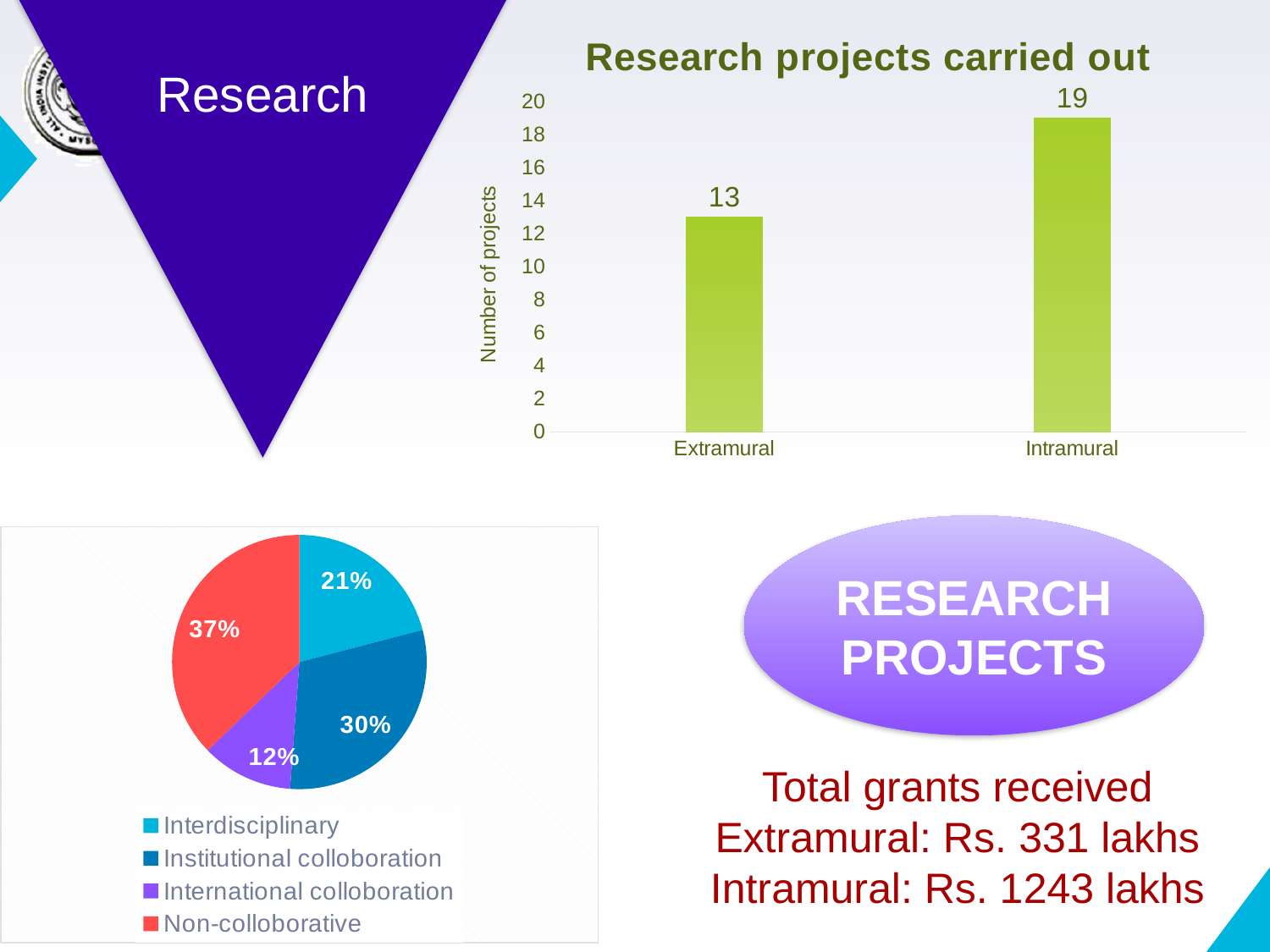
In the 'Research projects carried out' bar chart, how many projects are shown for Intramural? 19 In the 'Research projects carried out' bar chart, what is the difference between the Intramural and Extramural project counts? 6 In the 'Research projects carried out' bar chart, how many projects are shown for Extramural? 13 In the 'Research projects carried out' bar chart, which category has the higher number of projects? Intramural In the 'Research projects carried out' bar chart, how many categories are plotted? 2 In the pie chart at the bottom left, what share is shown for Institutional colloboration? 30% In the pie chart at the bottom left, how many categories does the legend list? 4 What type of chart is 'Research projects carried out'? Bar chart In the pie chart at the bottom left, which is larger: the share for Interdisciplinary or the share for International colloboration? Interdisciplinary In the 'Research projects carried out' bar chart, what is the label of the vertical axis? Number of projects In the pie chart at the bottom left, what share is shown for Non-colloborative? 37% In the pie chart at the bottom left, which category has the smallest share? International colloboration